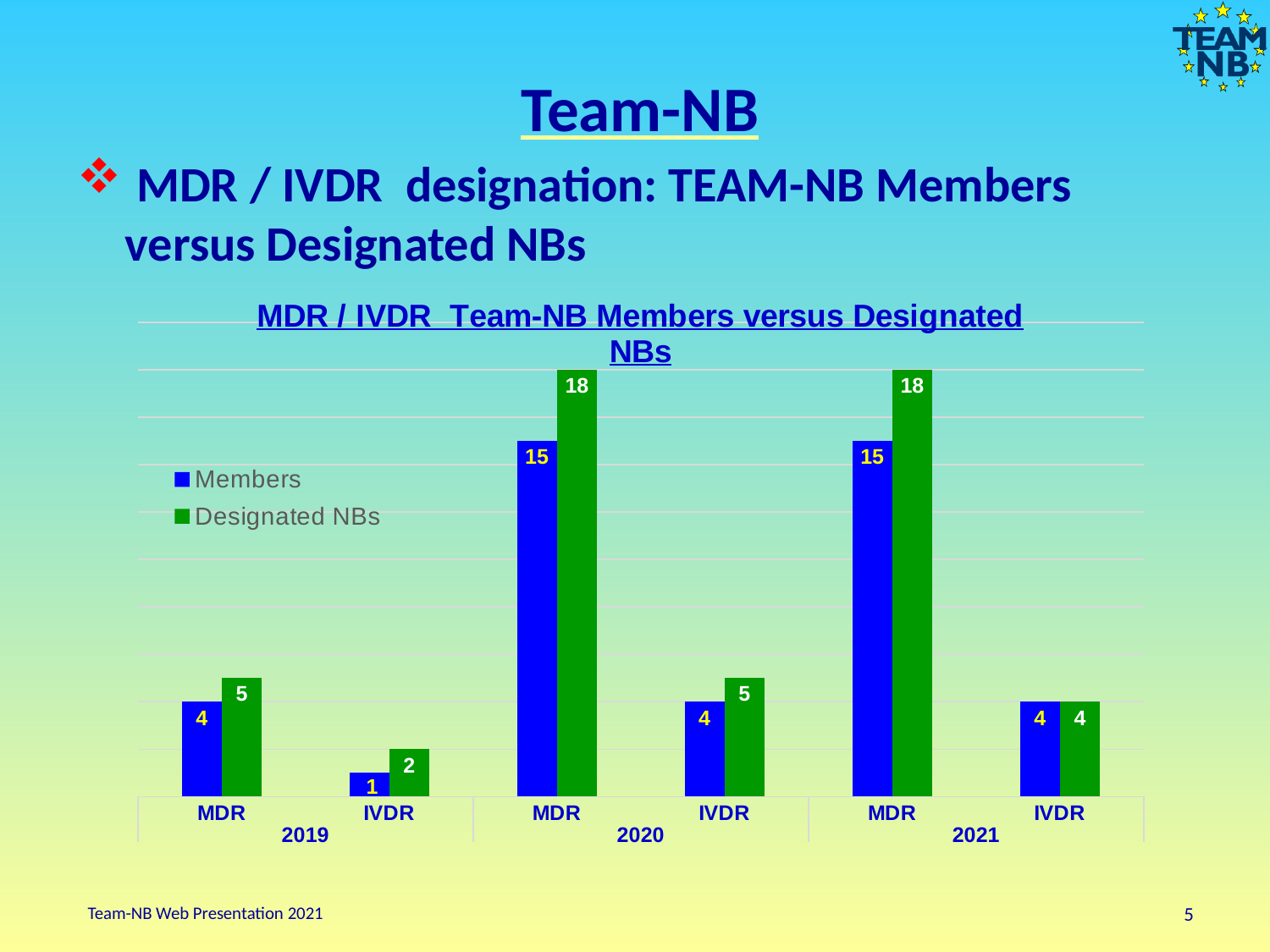
How many categories are shown on the x axis? 6 What is the value for Designated NBs for IVDR in 2019? 2 What colour are the Designated NBs bars? green How many series does the legend list? 2 What is the value for Designated NBs for MDR in 2020? 18 Which category has the lowest Members value? IVDR 2019 What kind of chart is shown? bar chart What is the difference between Designated NBs and Members for MDR in 2021? 3 What is the value for Members for MDR in 2019? 4 What is the value for Members for IVDR in 2021? 4 Which is larger for IVDR in 2020: Members or Designated NBs? Designated NBs How does the Members value for MDR change from 2019 to 2020? rises